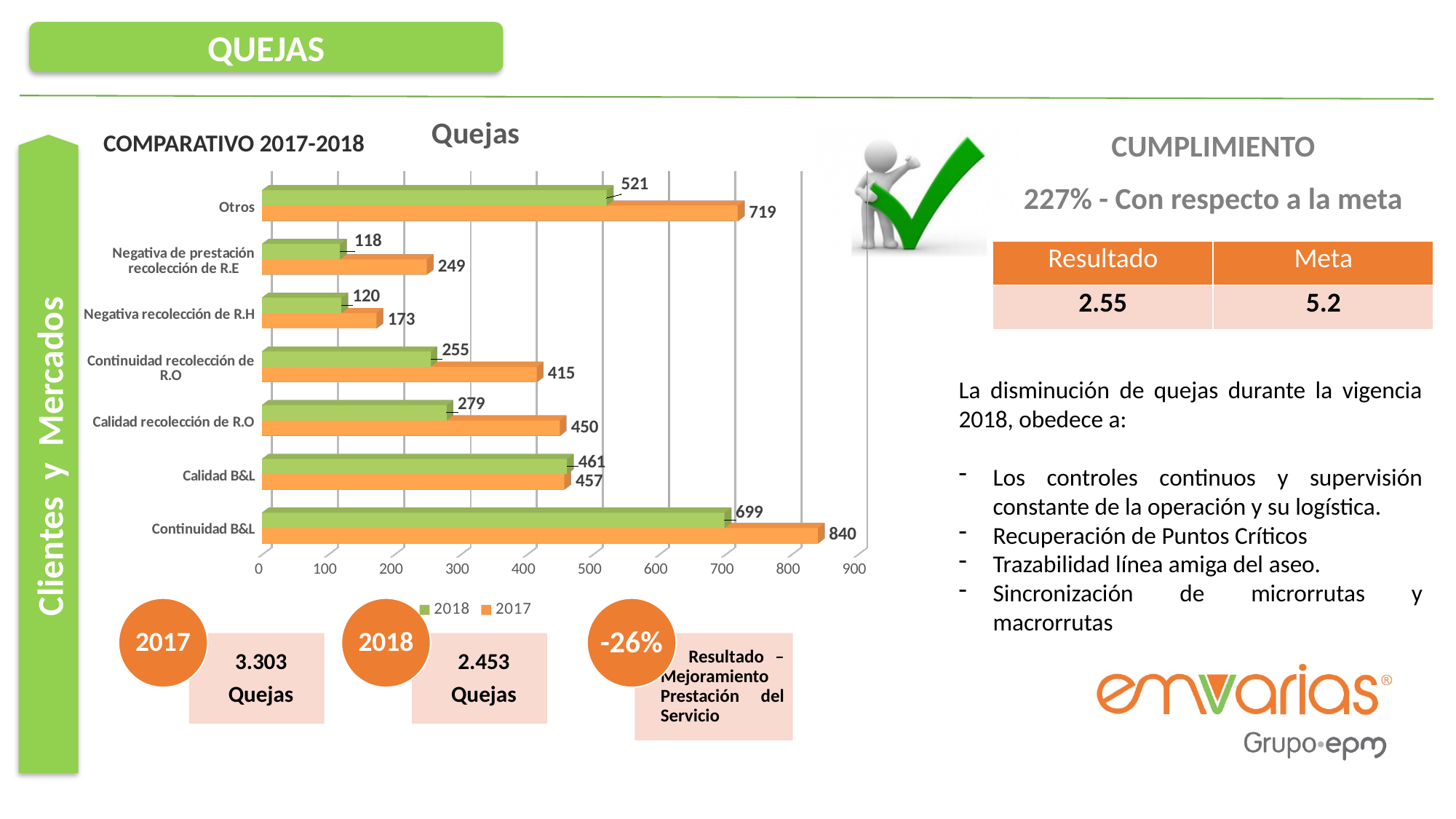
Which is larger for Calidad B&L, the 2018 value or the 2017 value? 2018 Which category has the lowest 2018 value? Negativa de prestación recolección de R.E What is the 2018 value for Otros? 521 How many categories are shown on the chart? 7 What is the difference between the 2017 and 2018 values for Continuidad recolección de R.O? 160 What is the 2017 value for Continuidad B&L? 840 What is the 2017 value for Negativa recolección de R.H? 173 What is the 2018 value for Calidad recolección de R.O? 279 How many series does the legend list? 2 What is the title of the chart? Quejas What kind of chart is shown? Bar chart Which category has the highest 2017 value? Continuidad B&L